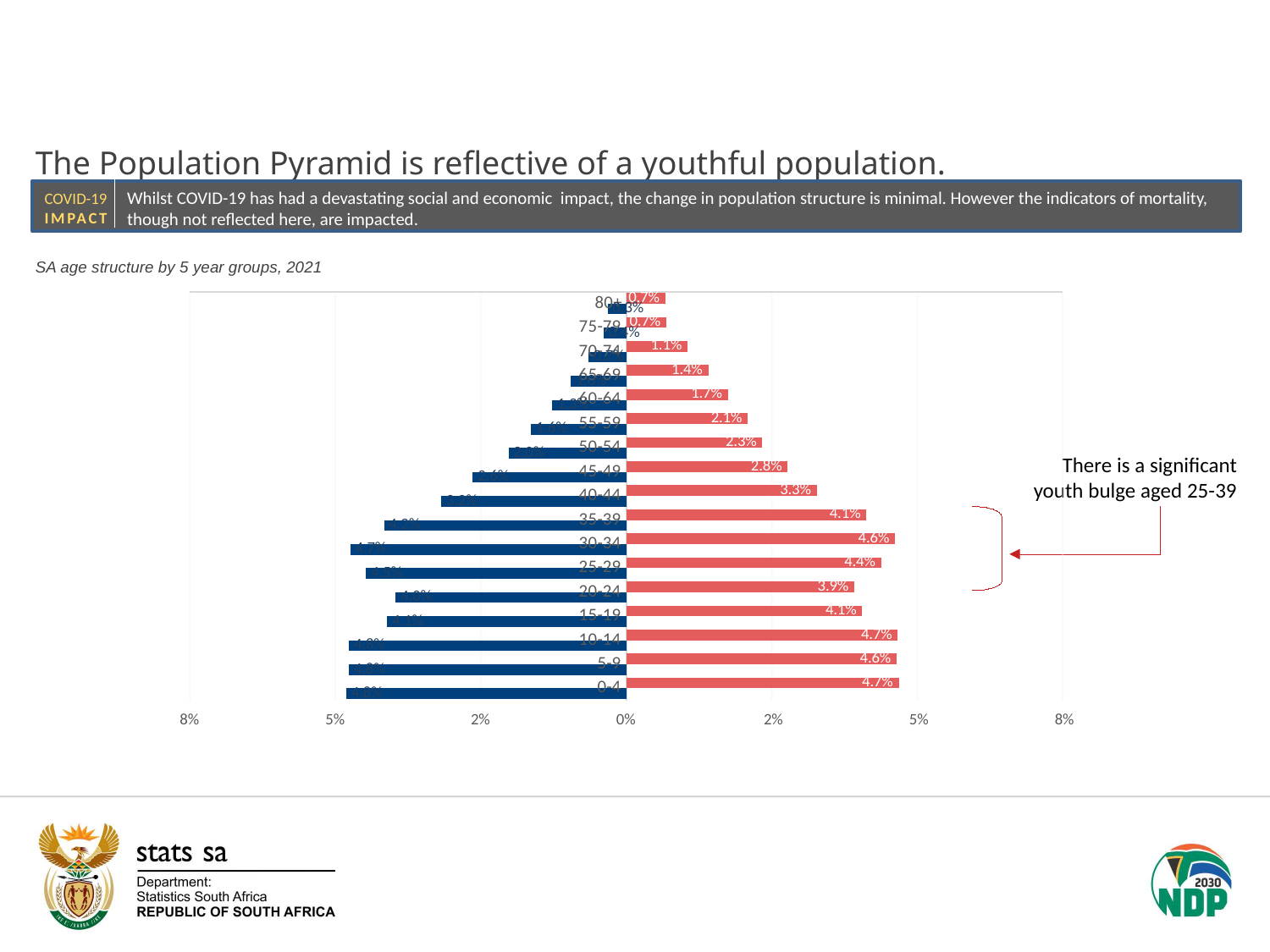
What kind of chart is shown on the slide? Bar chart What is the value of the red bar for the 0-4 age group? 4.7% What is the value of the red bar for the 80+ age group? 0.7% Which red bar is larger, 55-59 or 60-64? 55-59 How many age groups are shown on the chart? 17 Do the red bar values generally increase or decrease as the age groups get older from 0-4 to 80+? decrease What is the title printed above the chart? SA age structure by 5 year groups, 2021 What is the difference between the red bar values for 35-39 and 40-44? 0.8% Is the value of the blue bar for the 0-4 age group greater or less than 2%? greater What is the value of the red bar for the 45-49 age group? 2.8% Which red bar is larger, 30-34 or 25-29? 30-34 What is the value of the red bar for the 35-39 age group? 4.1%